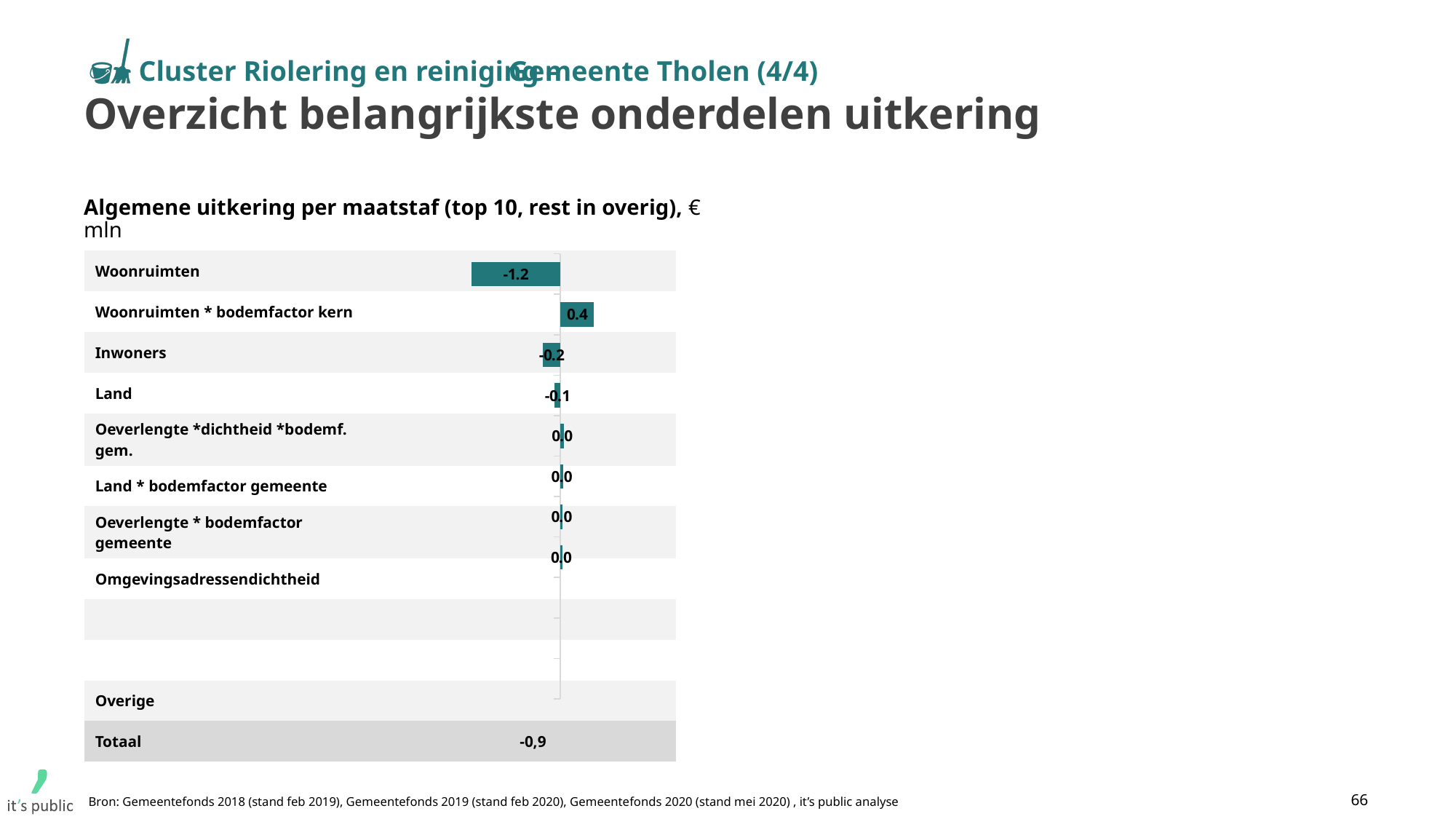
What is the value for Woonruimten * bodemfactor kern? 0.4 What is the value for Woonruimten? -1.2 What unit is stated in the chart title? € mln What kind of chart is shown on the slide? Bar chart What is the value shown for Totaal? -0,9 Which category has the lowest (most negative) value? Woonruimten What is the difference between the values for Woonruimten * bodemfactor kern and Woonruimten? 1.6 Which category has the highest value? Woonruimten * bodemfactor kern Which is larger, the value for Inwoners or the value for Land? Land What is the title of the chart? Algemene uitkering per maatstaf (top 10, rest in overig), € mln What is the value for Inwoners? -0.2 What is the value for Land? -0.1